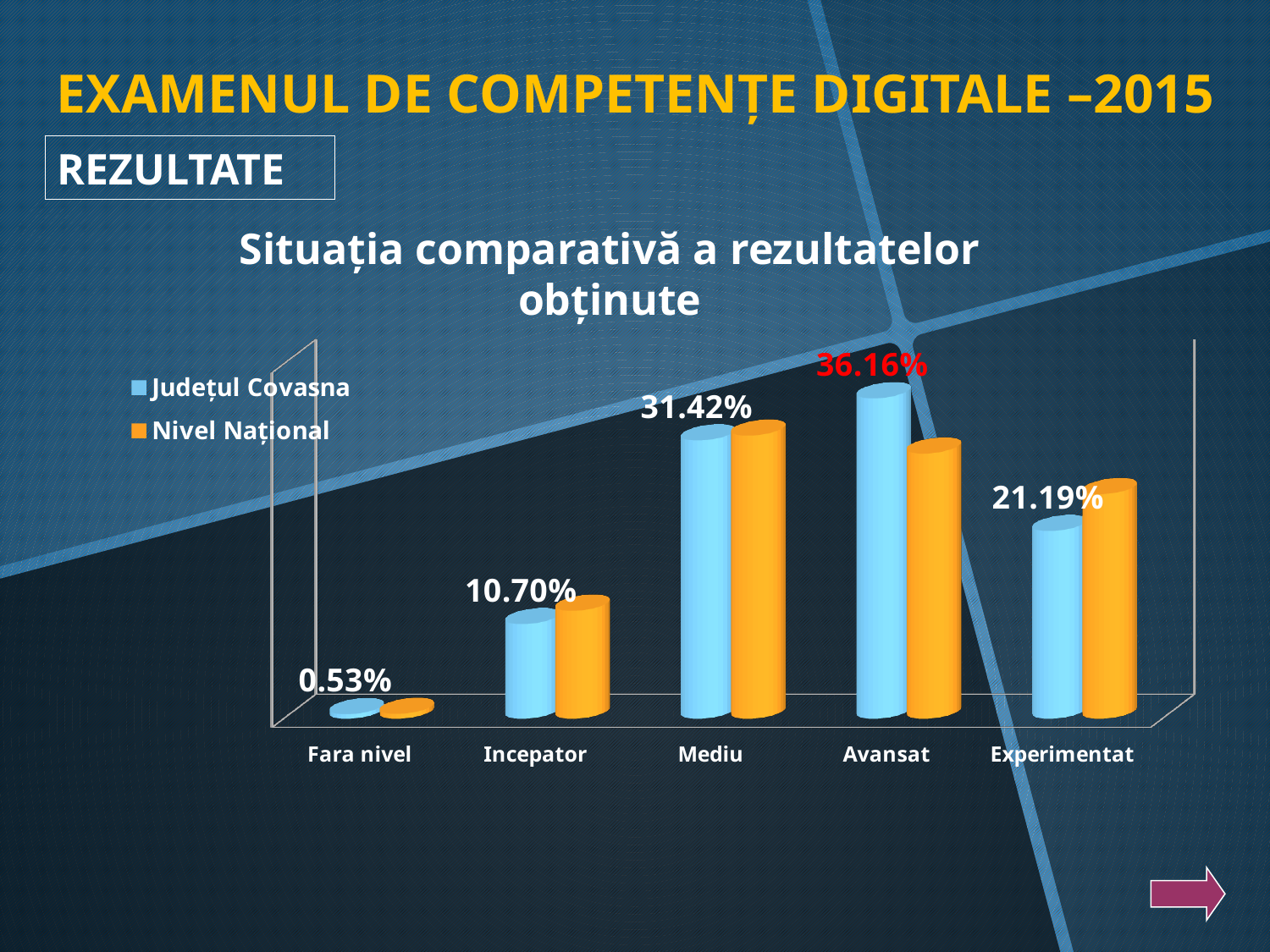
How many categories are shown on the x axis of the chart? 5 What is the value for Județul Covasna in the Incepator category? 10.70% In the Avansat category, which series has the larger value, Județul Covasna or Nivel Național? Județul Covasna What is the value for Județul Covasna in the Fara nivel category? 0.53% Which category has the lowest value for Județul Covasna? Fara nivel How many series does the chart legend list? 2 What is the value for Județul Covasna in the Experimentat category? 21.19% What is the difference between the Județul Covasna values for Avansat and Mediu? 4.74% Which category has the highest value for Județul Covasna? Avansat What is the value for Județul Covasna in the Avansat category? 36.16% What is the value for Județul Covasna in the Mediu category? 31.42% In the Experimentat category, which series has the larger value, Județul Covasna or Nivel Național? Nivel Național